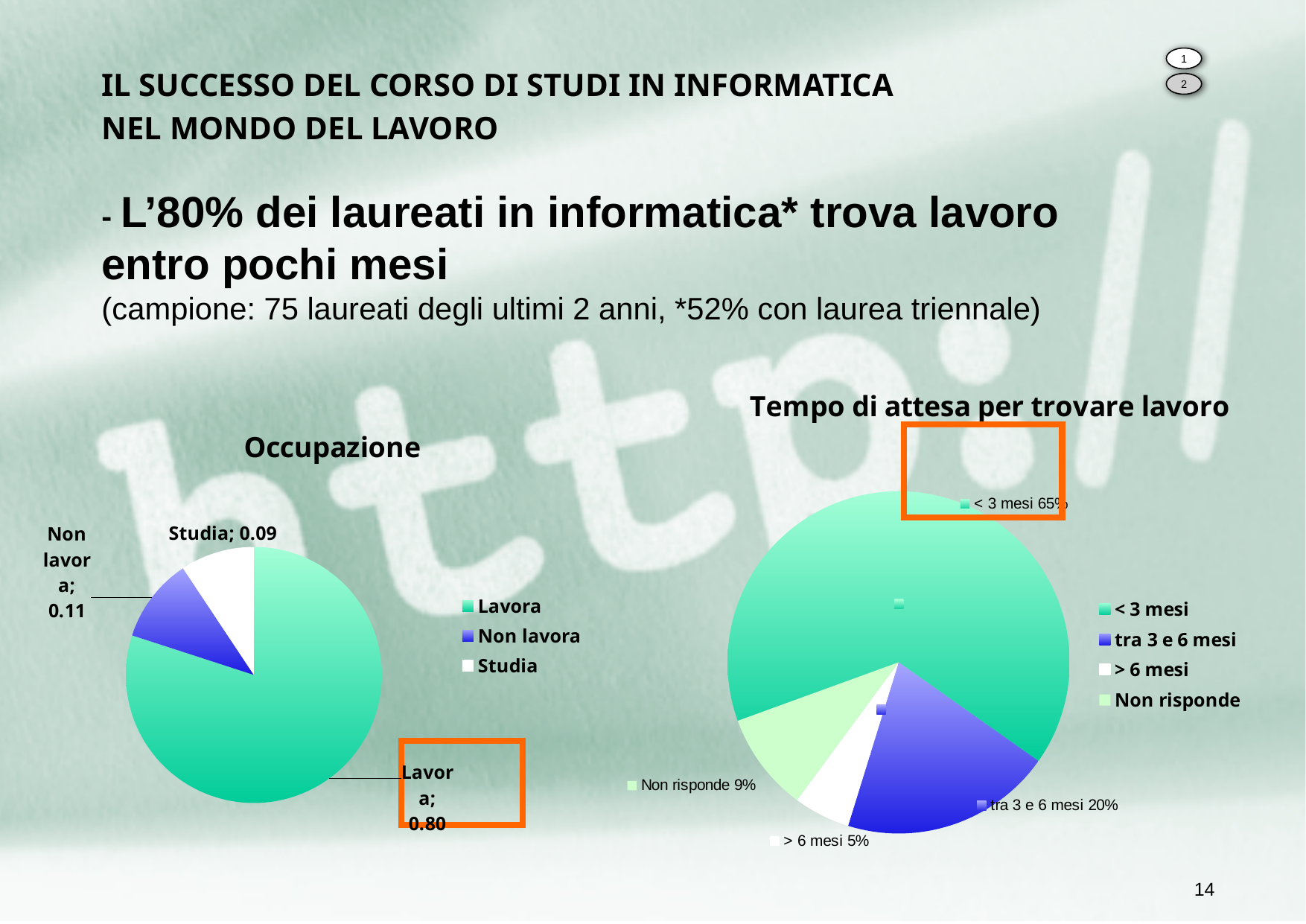
In the "Occupazione" chart, what is the value for Non lavora? 0.11 In the "Tempo di attesa per trovare lavoro" chart, what is the share for Non risponde? 9% In the "Occupazione" chart, which category has the largest slice? Lavora In the "Tempo di attesa per trovare lavoro" chart, which category has the smallest slice? > 6 mesi What kind of chart is the "Occupazione" chart? pie chart In the "Occupazione" chart, how many categories does the legend list? 3 In the "Tempo di attesa per trovare lavoro" chart, what is the share for tra 3 e 6 mesi? 20% In the "Occupazione" chart, what is the value for Lavora? 0.80 In the "Occupazione" chart, what is the value for Studia? 0.09 In the "Tempo di attesa per trovare lavoro" chart, what is the difference between the shares for < 3 mesi and tra 3 e 6 mesi? 45% In the "Tempo di attesa per trovare lavoro" chart, how many slices does the pie have? 4 In the "Tempo di attesa per trovare lavoro" chart, what is the share for < 3 mesi? 65%